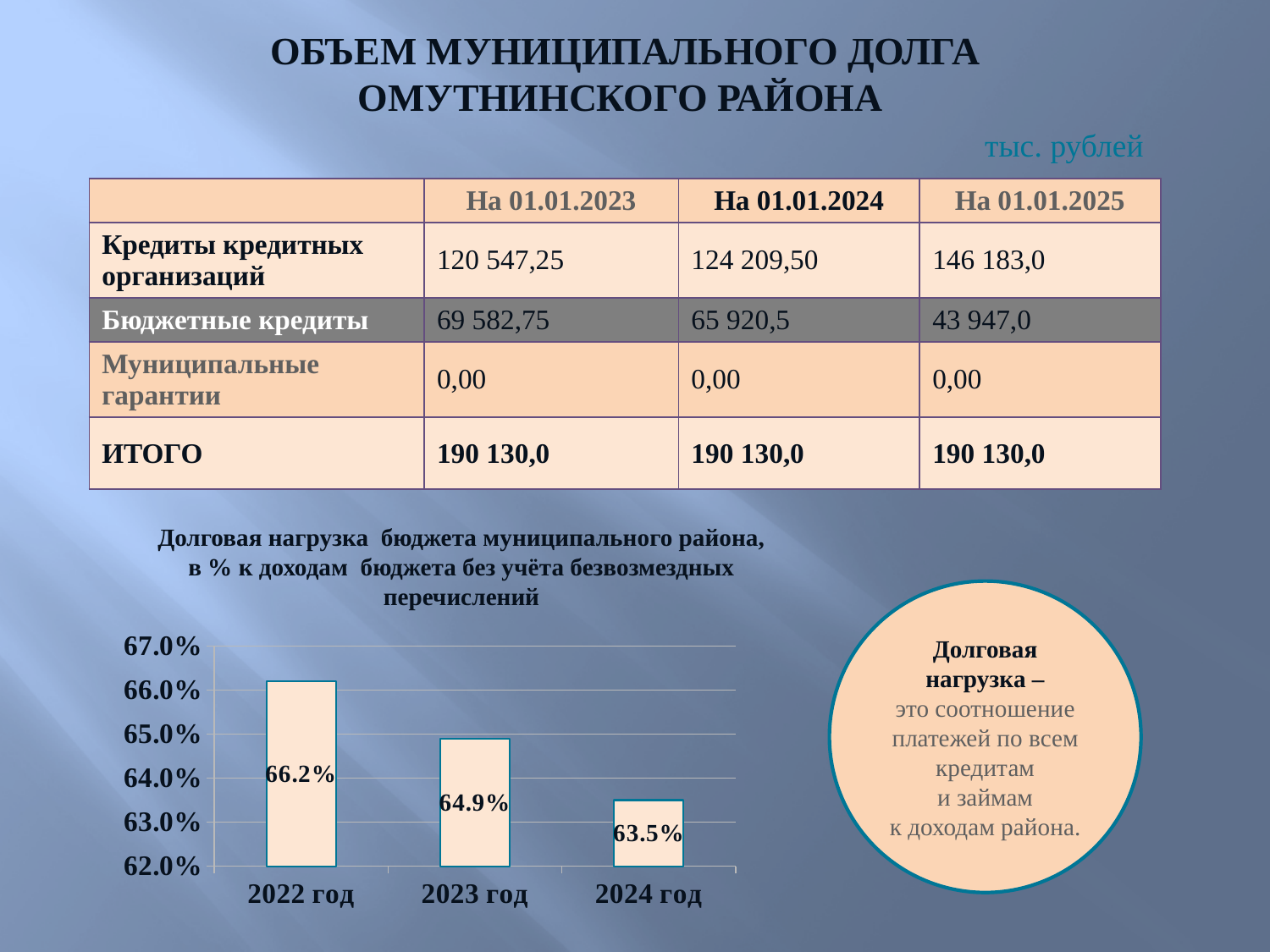
Which year has the highest value in the chart? 2022 год What is the value for 2022 год in the chart? 66.2% What is the difference between the values for 2022 год and 2024 год? 2.7% Which is larger, the value for 2023 год or the value for 2024 год? 2023 год How many years are shown in the chart? 3 Which year has the lowest value in the chart? 2024 год Is the value for 2023 год greater or less than 65.0%? less What is the value for 2024 год in the chart? 63.5% Do the values rise or fall from 2022 год to 2024 год? fall What is the difference between the values for 2022 год and 2023 год? 1.3% What kind of chart is shown on the slide? bar chart What is the value for 2023 год in the chart? 64.9%